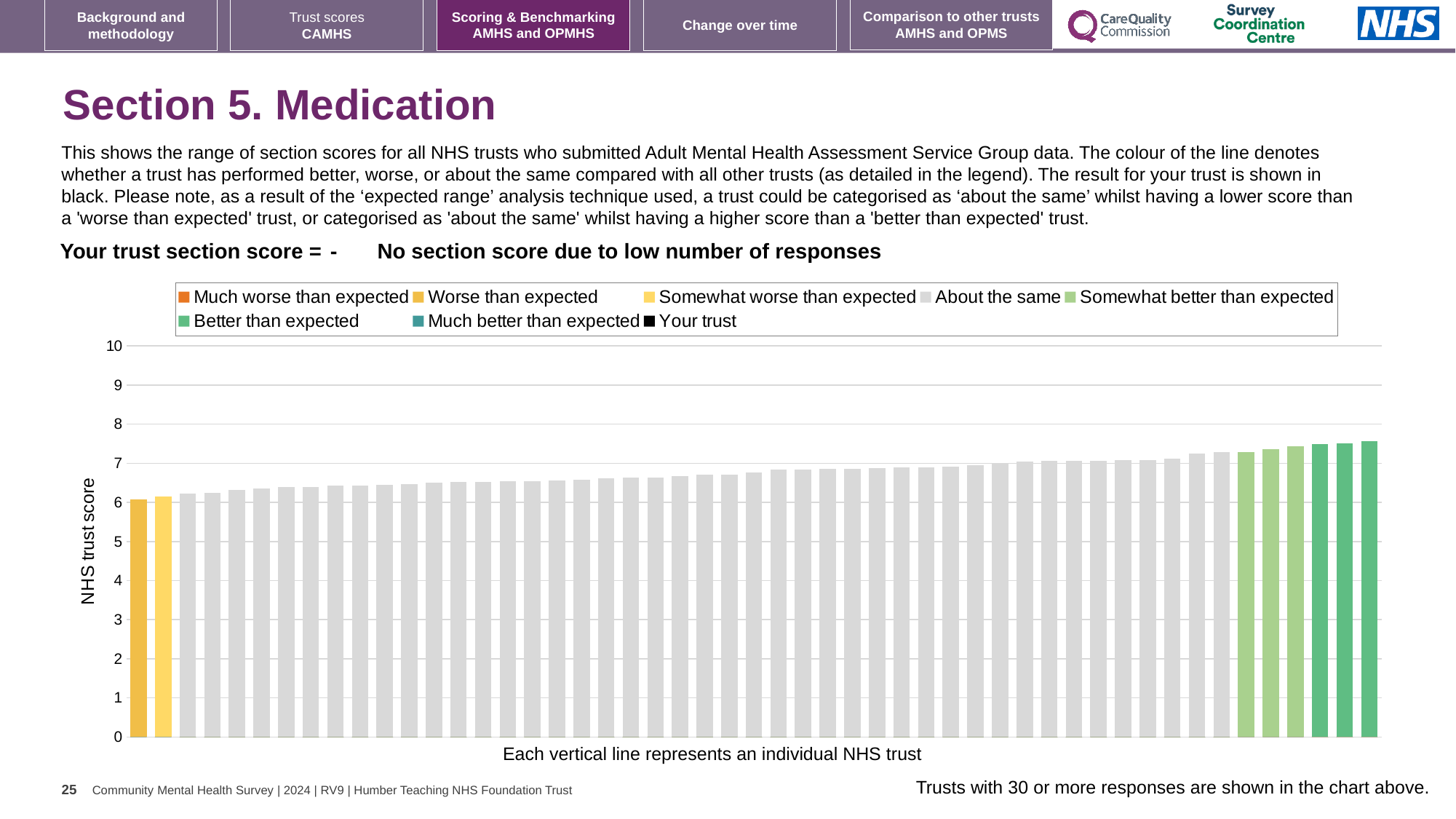
How many entries does the chart legend list? 8 Is the value of the tallest bar greater or less than 7? greater How many bars are coloured green (somewhat better or better than expected)? 6 What kind of chart is shown on the slide? Bar chart Is the value of the shortest bar greater or less than 7? less Is the value of the tallest bar greater or less than 8? less Do the bar values rise or fall from left to right along the x axis? Rise Which bar is taller, the leftmost bar or the rightmost bar? The rightmost bar What is the highest value shown on the y axis? 10 What is the title of the y axis? NHS trust score How many bars are coloured yellow (worse or somewhat worse than expected)? 2